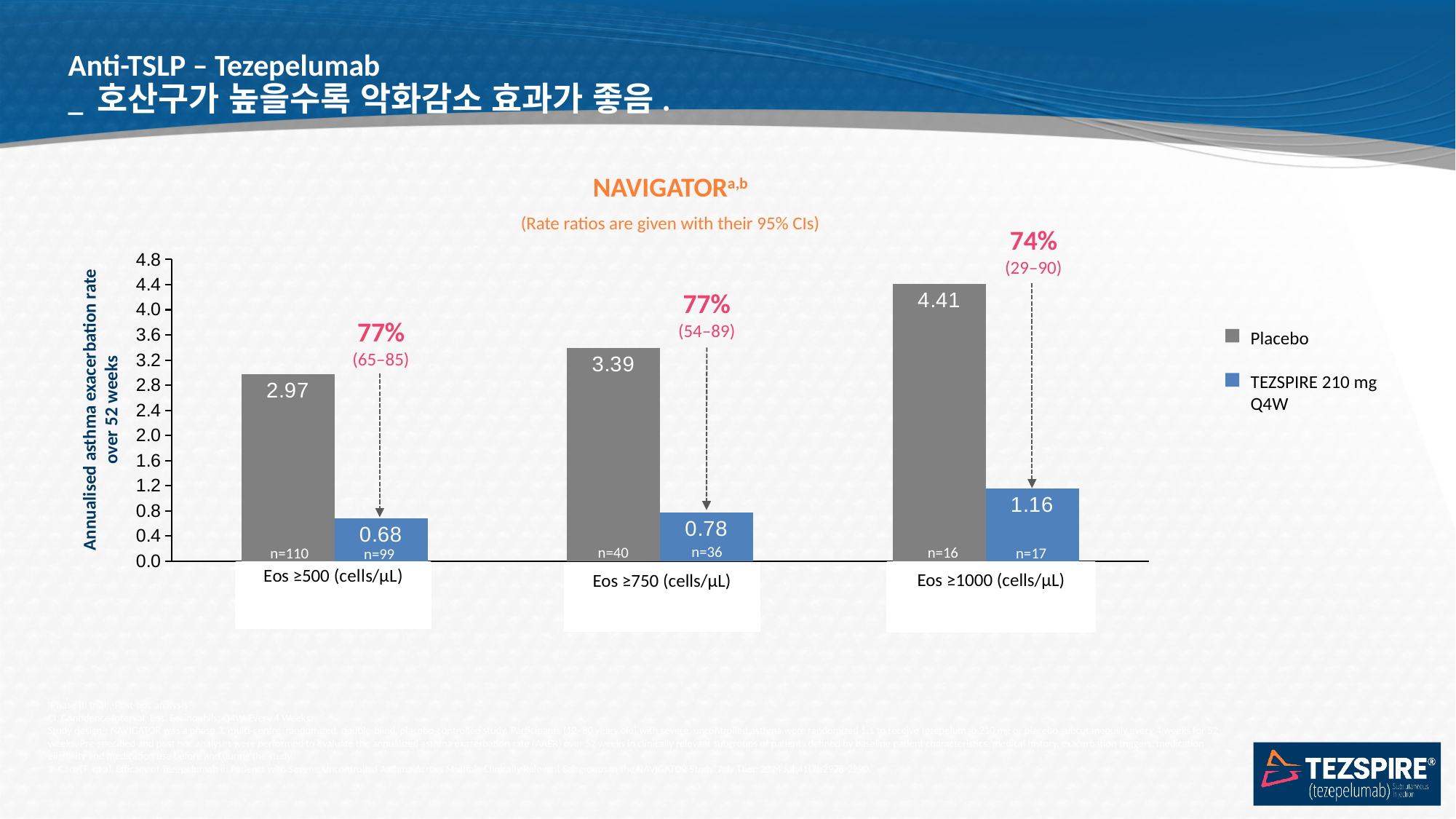
What is the difference between the Placebo and TEZSPIRE 210 mg Q4W exacerbation rates in the Eos ≥1000 (cells/µL) group? 3.25 Which eosinophil group has the highest Placebo exacerbation rate? Eos ≥1000 (cells/µL) What percentage reduction is shown above the Eos ≥1000 (cells/µL) group? 74% Which is larger: the Placebo rate in the Eos ≥750 group or the Placebo rate in the Eos ≥500 group? Placebo rate in the Eos ≥750 group What is the annualised asthma exacerbation rate for TEZSPIRE 210 mg Q4W in the Eos ≥1000 (cells/µL) group? 1.16 How many series does the legend list? 2 Which eosinophil group has the lowest TEZSPIRE 210 mg Q4W exacerbation rate? Eos ≥500 (cells/µL) What kind of chart is shown on the slide? Bar chart Is the Placebo value for the Eos ≥1000 (cells/µL) group greater or less than 4.0? greater What is the annualised asthma exacerbation rate for Placebo in the Eos ≥500 (cells/µL) group? 2.97 How many eosinophil categories are shown on the x axis? 3 What is the annualised asthma exacerbation rate for TEZSPIRE 210 mg Q4W in the Eos ≥750 (cells/µL) group? 0.78